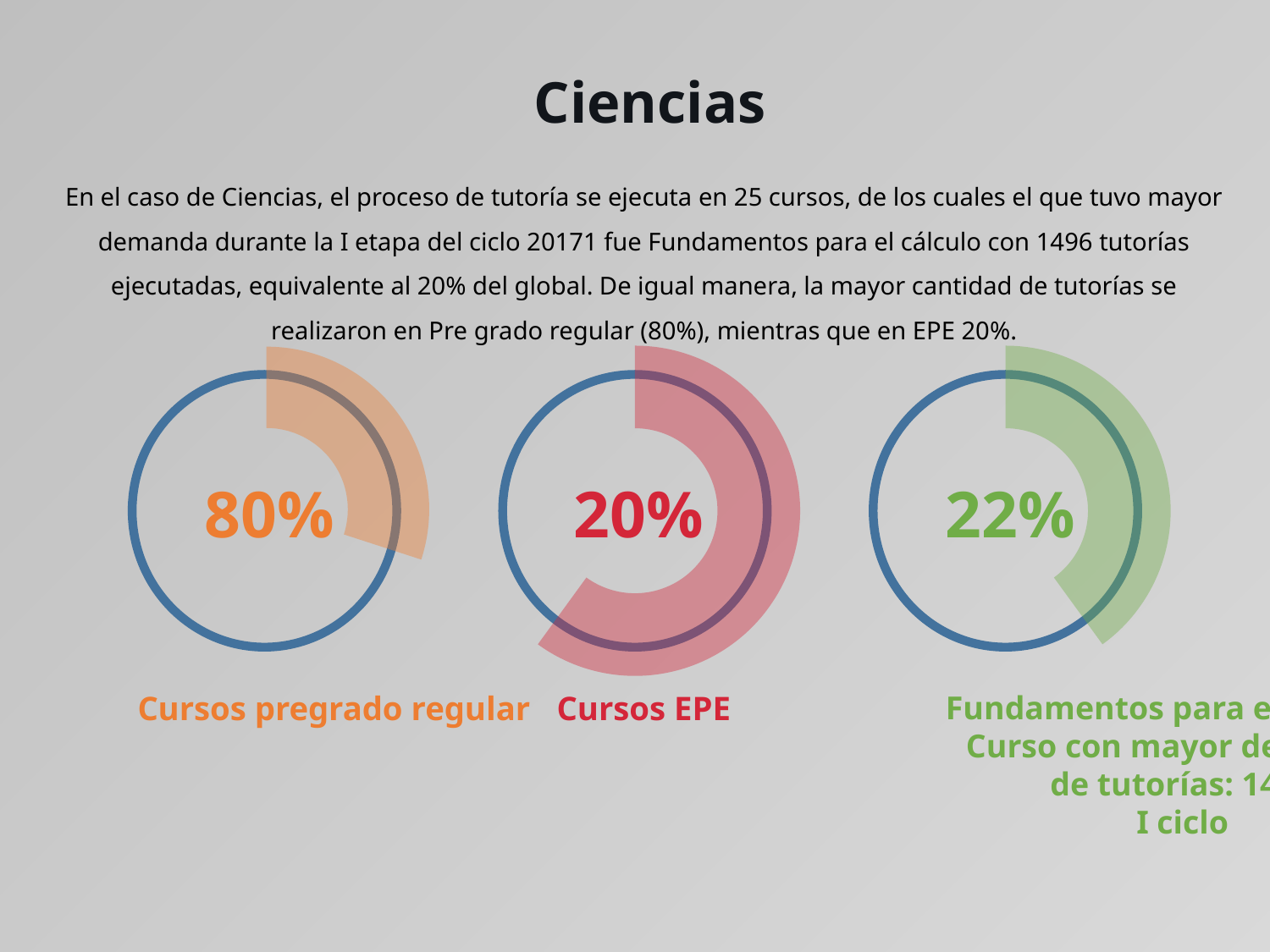
What is the difference between the 'Cursos pregrado regular' value and the 'Cursos EPE' value? 60% What value is shown in the 'Cursos EPE' chart? 20% What colour is the filled arc in the 'Cursos EPE' chart? Red What is the total of the 'Cursos pregrado regular' and 'Cursos EPE' values? 100% Which is larger, the value for 'Cursos EPE' or the value in the green chart on the right? The green chart on the right (22%) Which of the three charts shows the lowest percentage? Cursos EPE What value is shown in the green chart on the right of the slide? 22% What kind of chart is used to display the percentages on the slide? Donut (ring) chart What value is shown in the 'Cursos pregrado regular' chart? 80% What is the title of the slide? Ciencias How many ring charts are shown on the slide? 3 Which of the three charts shows the highest percentage? Cursos pregrado regular